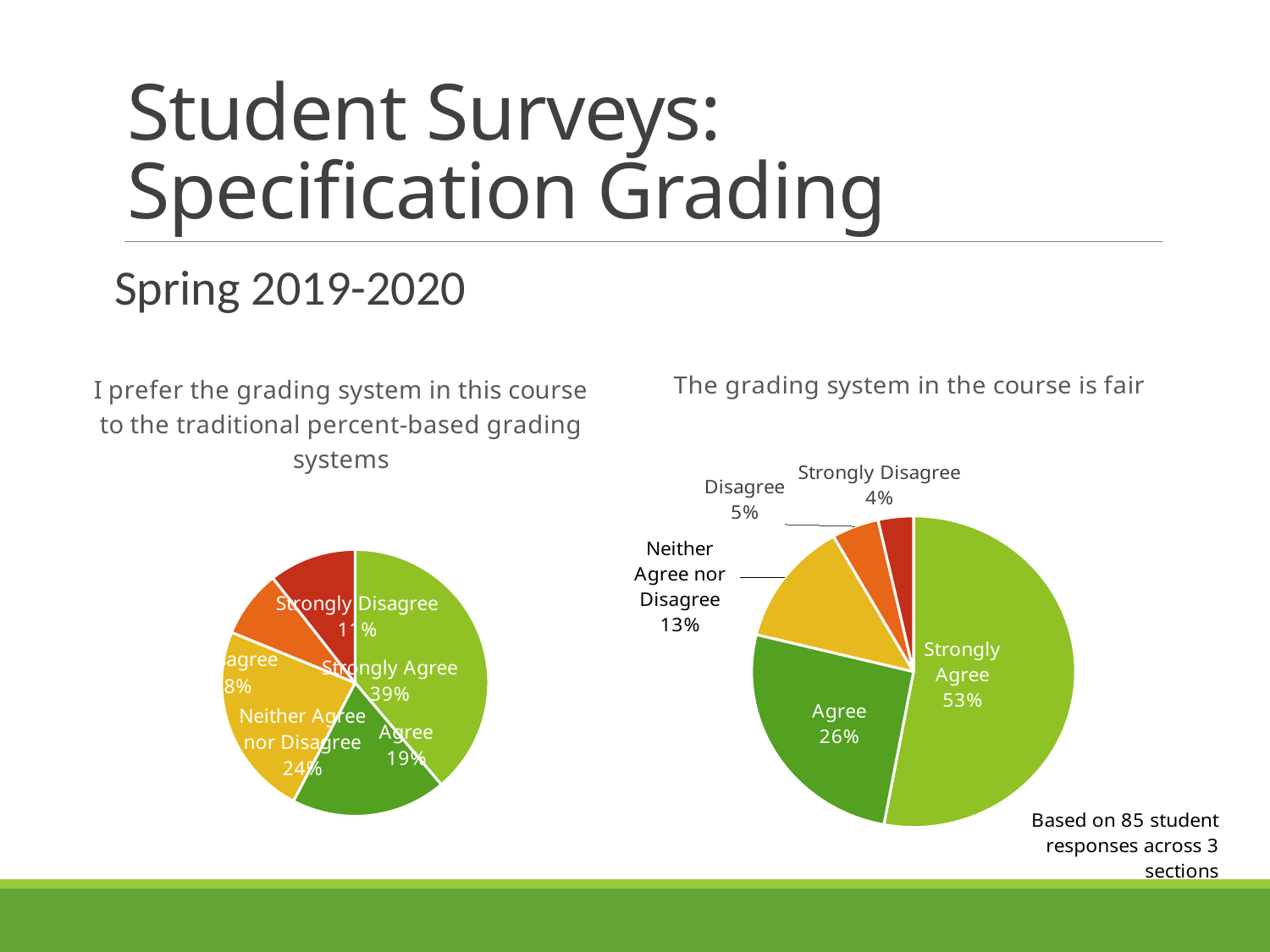
In the pie chart titled "The grading system in the course is fair", what share is Neither Agree nor Disagree? 13% In the left pie chart about preferring the grading system to traditional percent-based grading, what percentage of responses were Strongly Agree? 39% In the left pie chart about preferring the grading system to traditional percent-based grading, what percentage of responses were Neither Agree nor Disagree? 24% In the pie chart titled "The grading system in the course is fair", which response has the smallest slice? Strongly Disagree How many slices does the pie chart titled "The grading system in the course is fair" have? 5 In the pie chart titled "The grading system in the course is fair", what percentage of responses were Strongly Agree? 53% In the pie chart titled "The grading system in the course is fair", which response has the largest slice? Strongly Agree What type of chart is used on the right side of the slide for "The grading system in the course is fair"? Pie chart In the pie chart titled "The grading system in the course is fair", what percentage of responses were Strongly Disagree? 4% In the pie chart titled "The grading system in the course is fair", how many percentage points larger is Strongly Agree than Agree? 27 percentage points In the pie chart titled "The grading system in the course is fair", what percentage of responses were Agree? 26% Is the Strongly Agree share larger in the left chart (preferring the grading system) or the right chart (grading system is fair)? The right chart (grading system is fair)